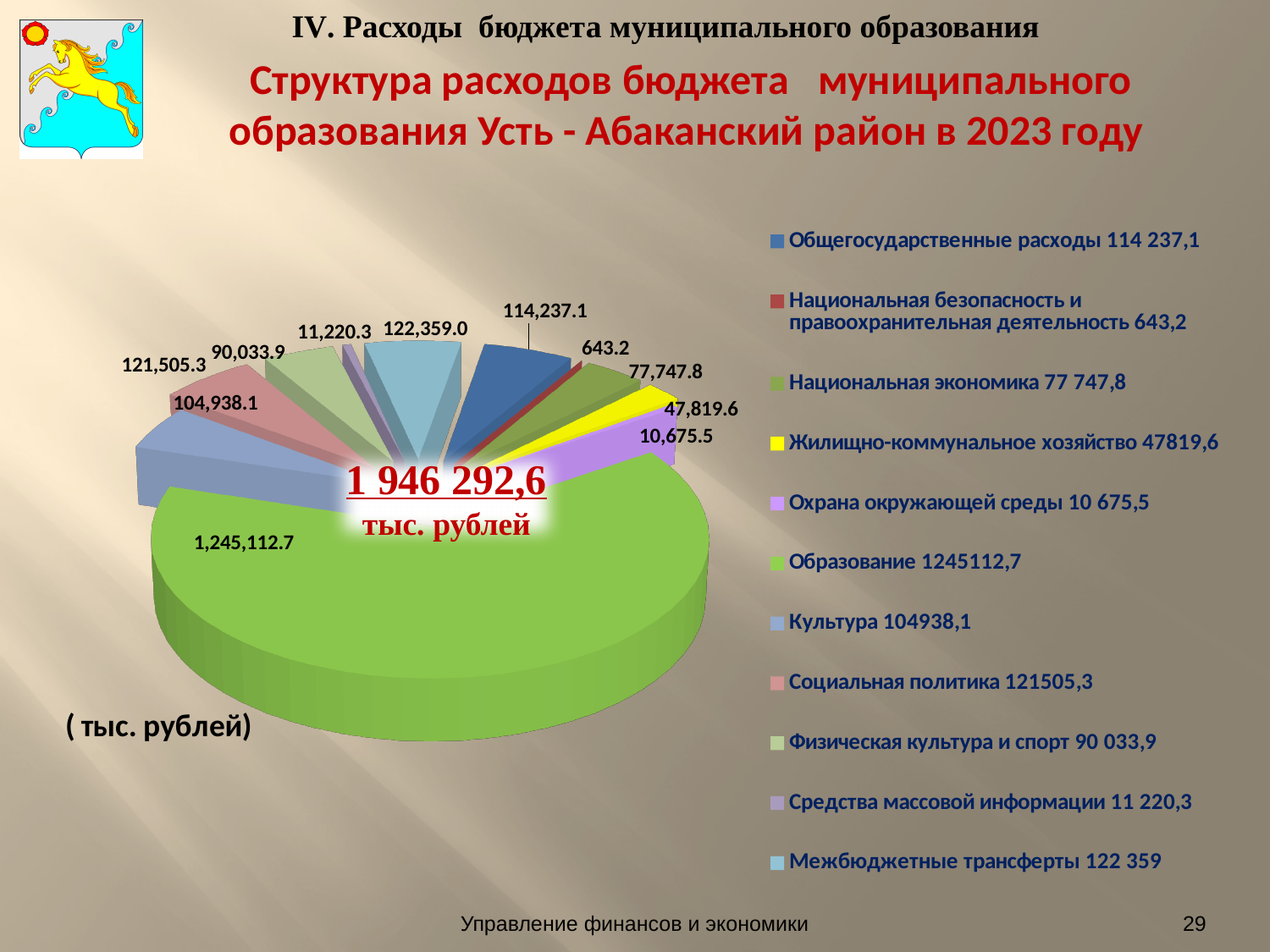
How many categories does the pie chart show? 11 What total amount is printed in the centre of the pie chart? 1 946 292,6 тыс. рублей What is the value for Межбюджетные трансферты? 122,359.0 Which category has the largest slice of the pie? Образование What is the value for Жилищно-коммунальное хозяйство? 47,819.6 What type of chart is shown on the slide? pie chart What is the value for Национальная безопасность и правоохранительная деятельность? 643.2 What is the value for Образование on the pie chart? 1,245,112.7 What is the difference between the values for Национальная экономика and Жилищно-коммунальное хозяйство? 29,928.2 Which category has the smallest slice of the pie? Национальная безопасность и правоохранительная деятельность What colour is the slice for Жилищно-коммунальное хозяйство? yellow Which is larger, the value for Культура or the value for Социальная политика? Социальная политика